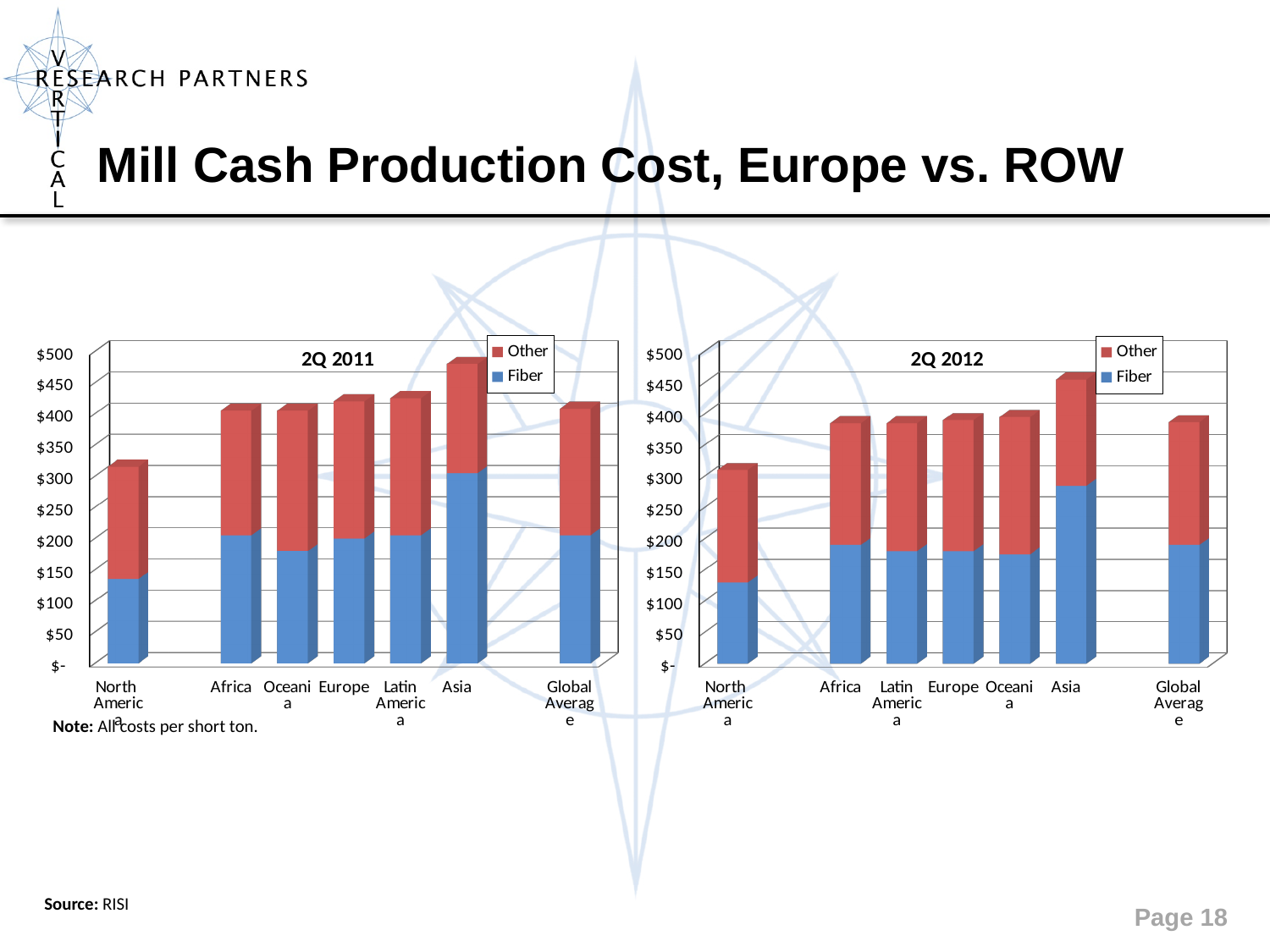
In the 2Q 2011 chart, is the total value for Asia greater or less than $450? greater In the 2Q 2012 chart, which is larger, the total for Asia or the total for North America? Asia In the 2Q 2012 chart, is the total value for Asia greater or less than $400? greater What kind of chart is the 2Q 2011 chart? stacked bar chart How many categories are shown on the x axis of the 2Q 2012 chart? 7 How many series does the legend of the 2Q 2011 chart list? 2 In the 2Q 2011 chart, is the total value for North America greater or less than $350? less In the 2Q 2012 chart, which region has the lowest total mill cash production cost? North America What are the two series listed in the legend of the 2Q 2012 chart? Other and Fiber What is the title of the chart on the left side of the slide? 2Q 2011 In the 2Q 2011 chart, which region has the highest total mill cash production cost? Asia